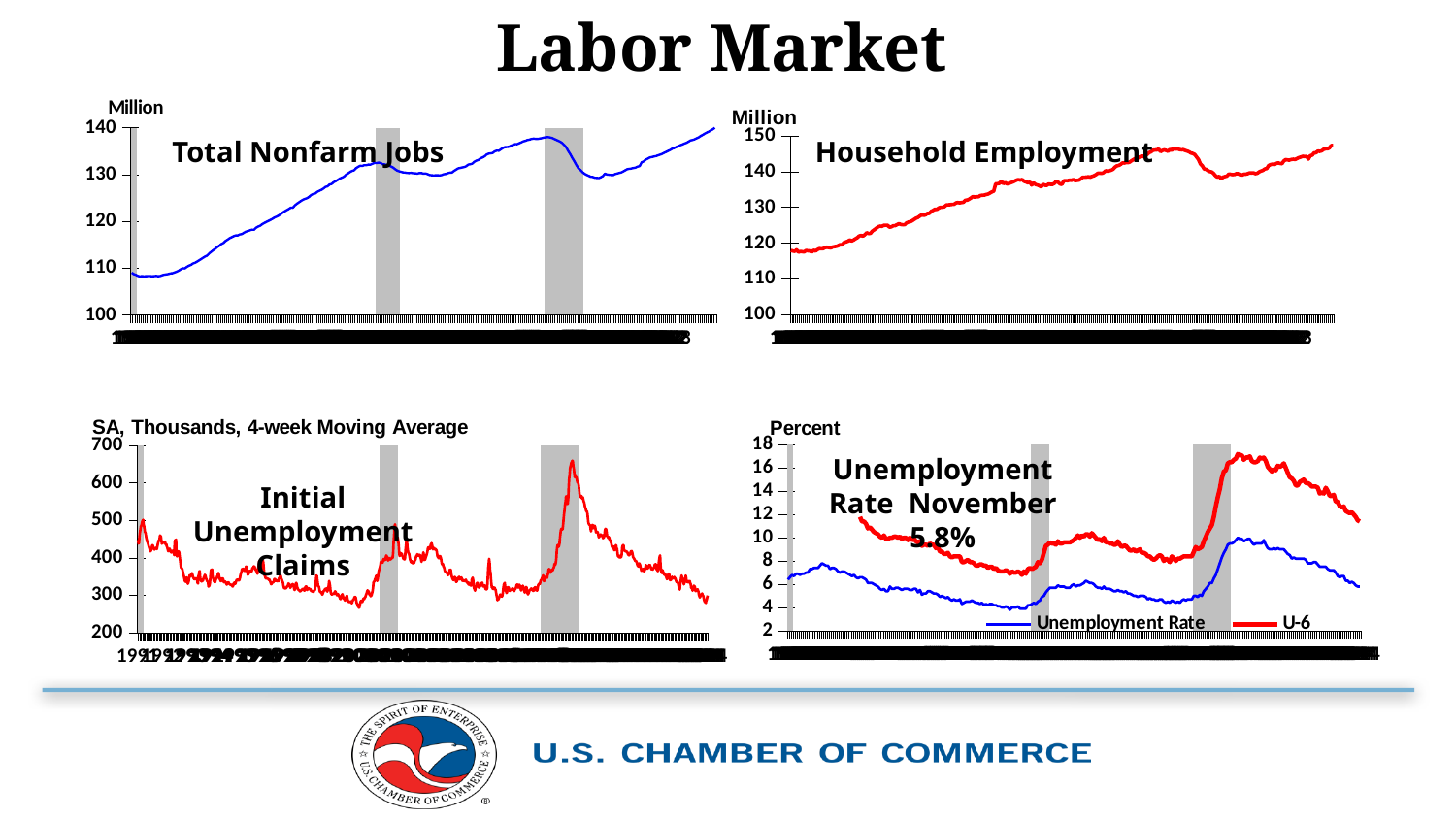
On the Household Employment chart, is the value at the end of the series greater or less than 140? greater On the Unemployment Rate chart, what is the unemployment rate for November? 5.8% On the Total Nonfarm Jobs chart, is the value at the start of the series greater or less than 110? less On the Total Nonfarm Jobs chart, is the value at the end of the series greater or less than 130? greater On the Household Employment chart, do values overall rise or fall along the x axis? rise What unit label is shown above the y axis of the Initial Unemployment Claims chart? SA, Thousands, 4-week Moving Average What are the two legend entries on the Unemployment Rate chart? Unemployment Rate and U-6 On the Unemployment Rate chart, which series is higher throughout, Unemployment Rate or U-6? U-6 How many series does the legend of the Unemployment Rate chart list? 2 What kind of chart is the Total Nonfarm Jobs chart? line chart